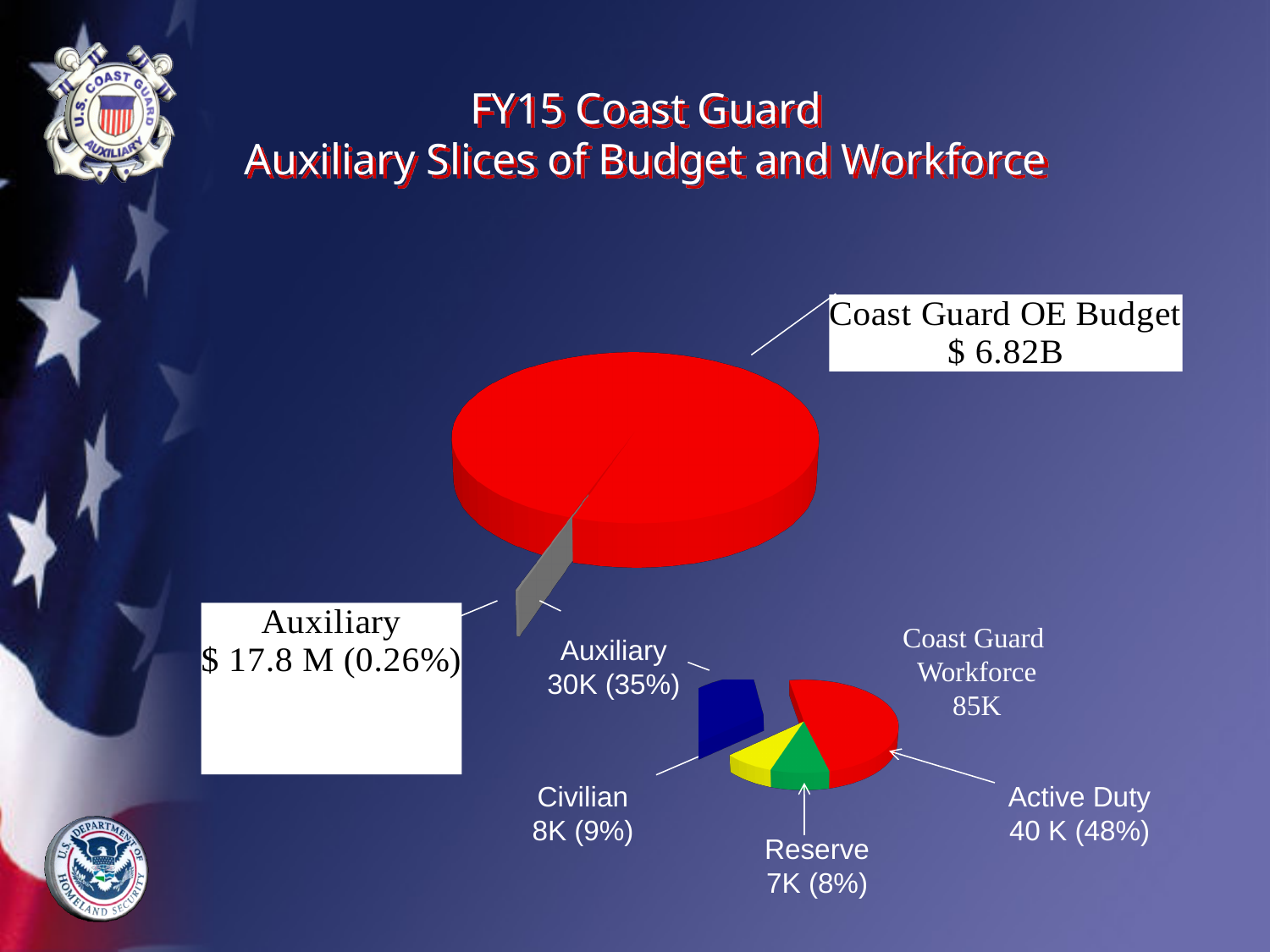
In the Coast Guard Workforce pie chart, what is the value for Civilian? 8K (9%) What type of chart is used to show the Coast Guard workforce breakdown? pie chart In the Coast Guard Workforce pie chart, what is the value for Reserve? 7K (8%) In the Coast Guard Workforce pie chart, what is the total workforce shown? 85K In the Coast Guard Workforce pie chart, which category has the largest slice? Active Duty In the Coast Guard OE Budget pie chart, what is the value of the Auxiliary slice? $ 17.8 M (0.26%) In the Coast Guard Workforce pie chart, which category has the smallest slice? Reserve In the Coast Guard OE Budget pie chart, what is the total Coast Guard OE Budget shown? $ 6.82B In the Coast Guard Workforce pie chart, what share of the workforce is Civilian? 9% In the Coast Guard Workforce pie chart, what is the value for Auxiliary? 30K (35%) In the Coast Guard Workforce pie chart, what is the value for Active Duty? 40 K (48%) In the Coast Guard Workforce pie chart, how many categories are shown? 4